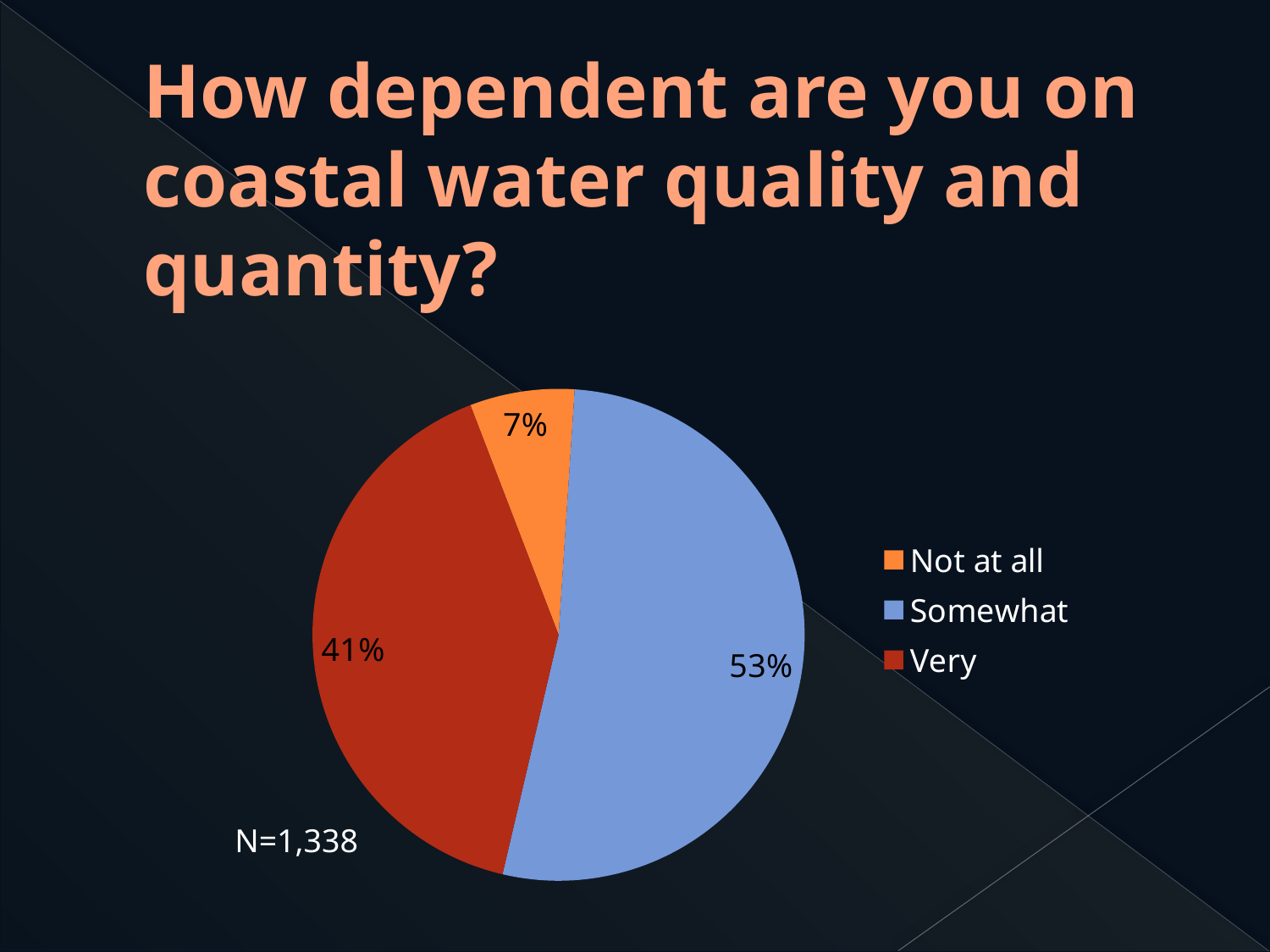
What percentage of respondents answered "Very"? 41% What is the difference in percentage points between the "Somewhat" and "Very" slices? 12 What percentage of respondents answered "Somewhat"? 53% What kind of chart is shown on the slide? Pie chart What is the sample size (N) shown on the slide? N=1,338 Which colour represents the "Very" category in the legend? Red Which response category has the smallest share of the pie? Not at all What is the difference in percentage points between the "Very" and "Not at all" slices? 34 Which is larger, the share for "Very" or the share for "Not at all"? Very Which response category has the largest share of the pie? Somewhat What percentage of respondents answered "Not at all"? 7% How many categories does the pie chart show? 3